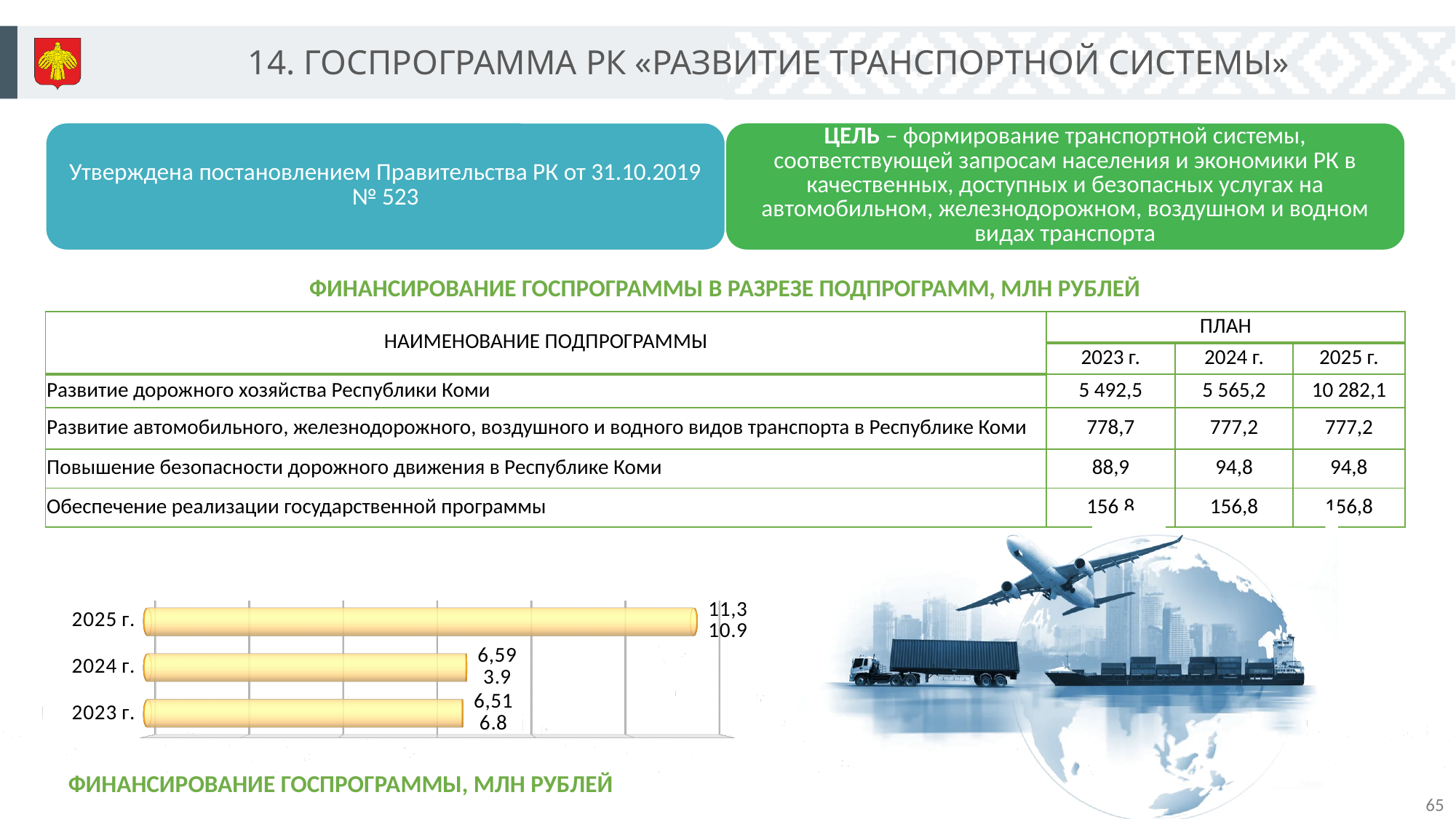
How many categories (years) does the bar chart show? 3 In the bar chart, is the bar for 2025 г. longer or shorter than the bar for 2023 г.? longer In the bar chart, what is the data label printed at the end of the bar for 2024 г. (the upper label)? 6,593.9 In the bar chart, what is the data label printed at the end of the bar for 2025 г. (the upper label)? 11,310.9 Going from 2023 г. to 2025 г., do the bar lengths in the bar chart generally increase or decrease? increase What is the title printed below the bar chart? ФИНАНСИРОВАНИЕ ГОСПРОГРАММЫ, МЛН РУБЛЕЙ What kind of chart is shown at the bottom left of the slide? bar chart Which year has the longest bar in the bar chart? 2025 г. What colour are the bars in the bar chart? yellow Which year is listed at the top of the bar chart? 2025 г. In the bar chart, what is the data label printed at the end of the bar for 2023 г. (the upper label)? 6,516.8 In the bar chart, is the bar for 2025 г. longer or shorter than the bar for 2024 г.? longer